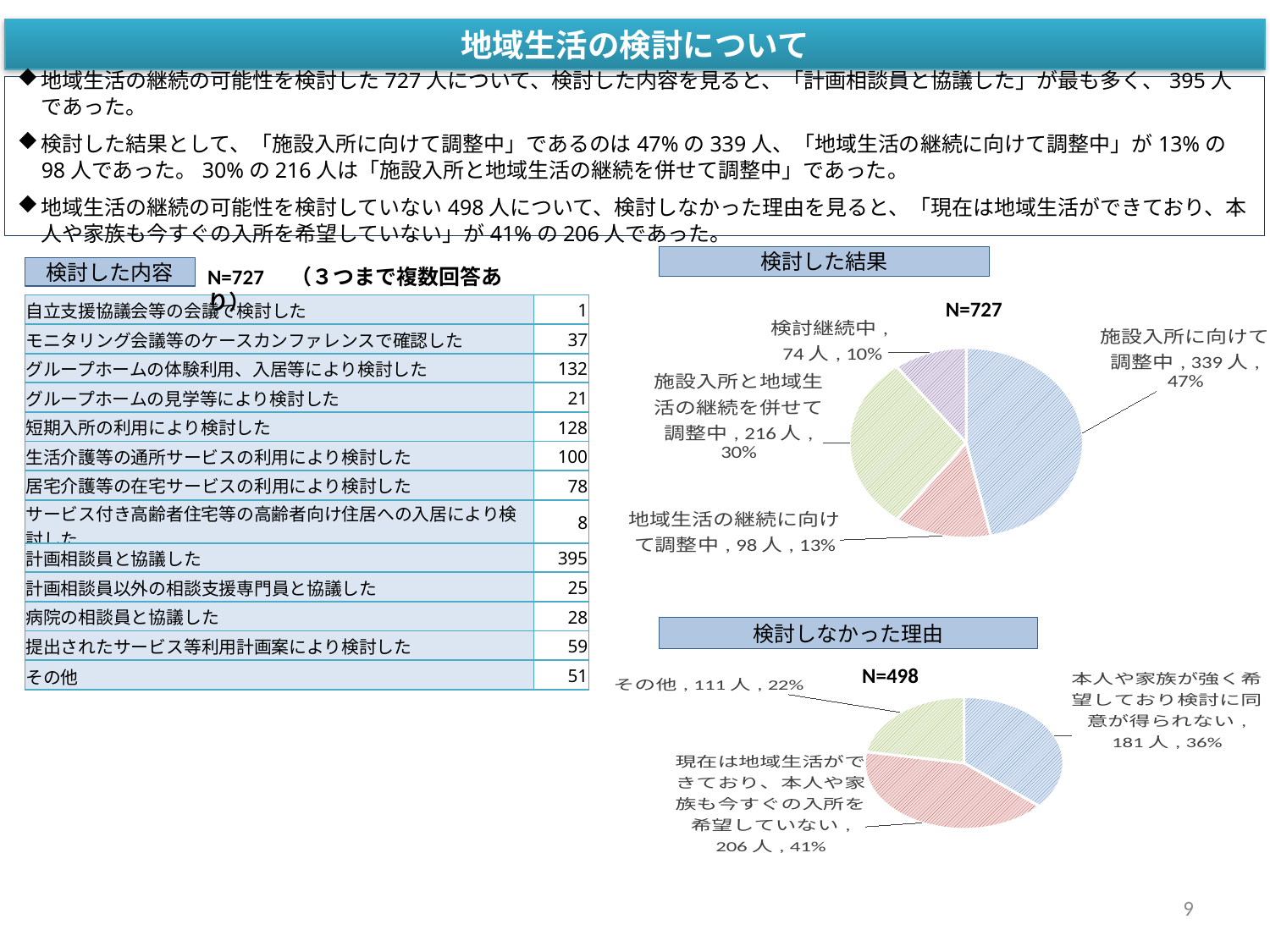
What is the N value shown for the 検討しなかった理由 pie chart? N=498 How many categories does the 検討しなかった理由 pie chart show? 3 In the 検討した結果 pie chart, which category has the largest slice? 施設入所に向けて調整中 In the 検討した結果 pie chart, how many people are in the 施設入所に向けて調整中 category? 339人 In the 検討しなかった理由 pie chart, what share does 本人や家族が強く希望しており検討に同意が得られない represent? 36% In the 検討した結果 pie chart, what is the difference in people between 施設入所に向けて調整中 and 地域生活の継続に向けて調整中? 241人 In the 検討しなかった理由 pie chart, which is larger: 現在は地域生活ができており、本人や家族も今すぐの入所を希望していない or その他? 現在は地域生活ができており、本人や家族も今すぐの入所を希望していない What type of chart is used for 検討しなかった理由? Pie chart In the 検討した結果 pie chart, what share does 施設入所と地域生活の継続を併せて調整中 represent? 30% In the 検討しなかった理由 pie chart, how many people chose その他? 111人 How many categories does the 検討した結果 pie chart show? 4 In the 検討した結果 pie chart, which category has the smallest slice? 検討継続中